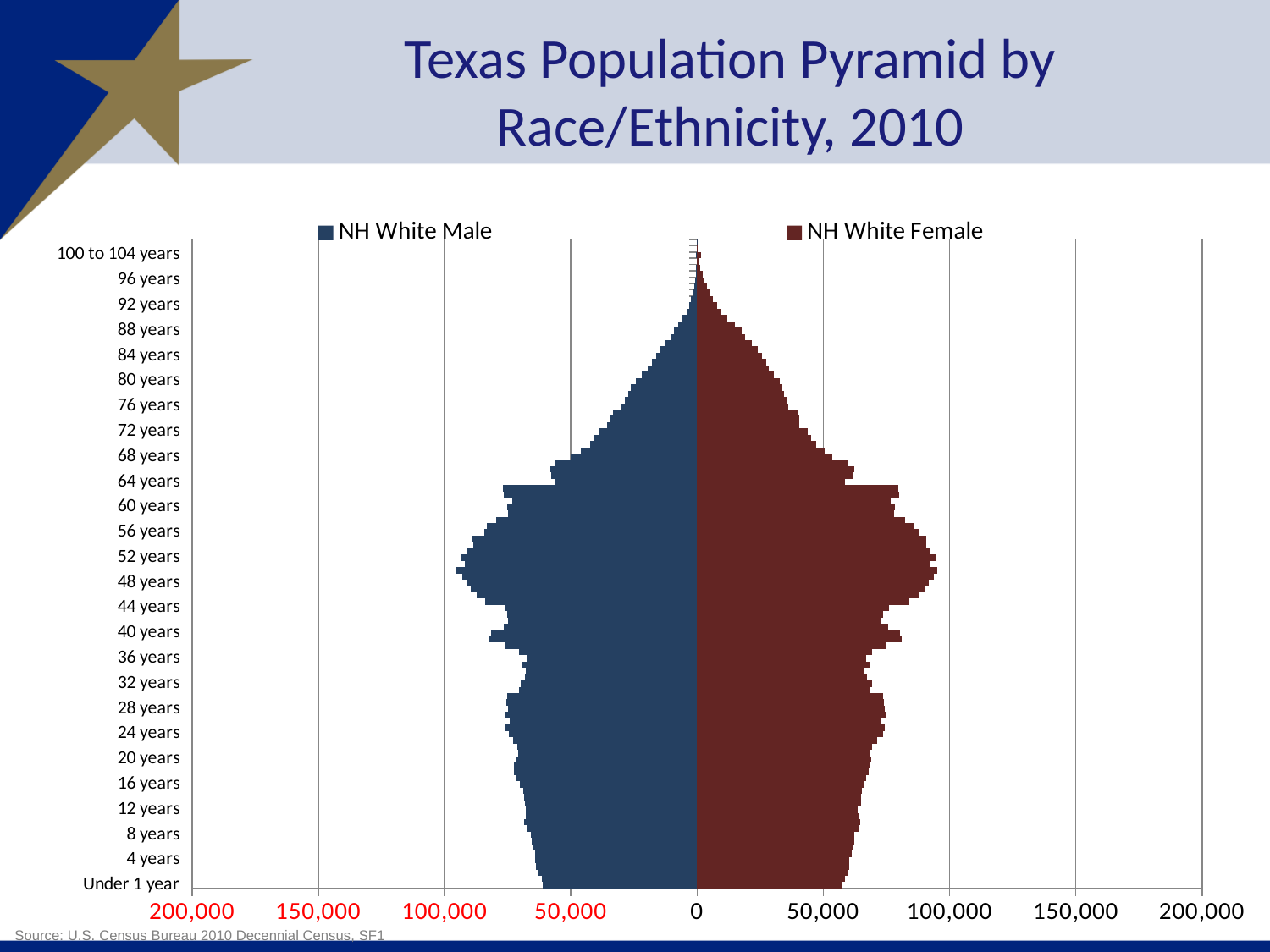
Which is larger, the NH White Female value for 48 years or for 92 years? 48 years What kind of chart is shown on the slide? bar chart How many series does the legend list? 2 Is the NH White Female value for 100 to 104 years greater or less than 50,000? less Is the NH White Male value for 76 years greater or less than 50,000? less Is the NH White Female value for 48 years greater or less than 50,000? greater Do the NH White Male values rise or fall as age increases from 48 years to 100 to 104 years? fall At 88 years, which series has the larger value, NH White Male or NH White Female? NH White Female What is the title of the chart? Texas Population Pyramid by Race/Ethnicity, 2010 What are the two series named in the legend? NH White Male and NH White Female